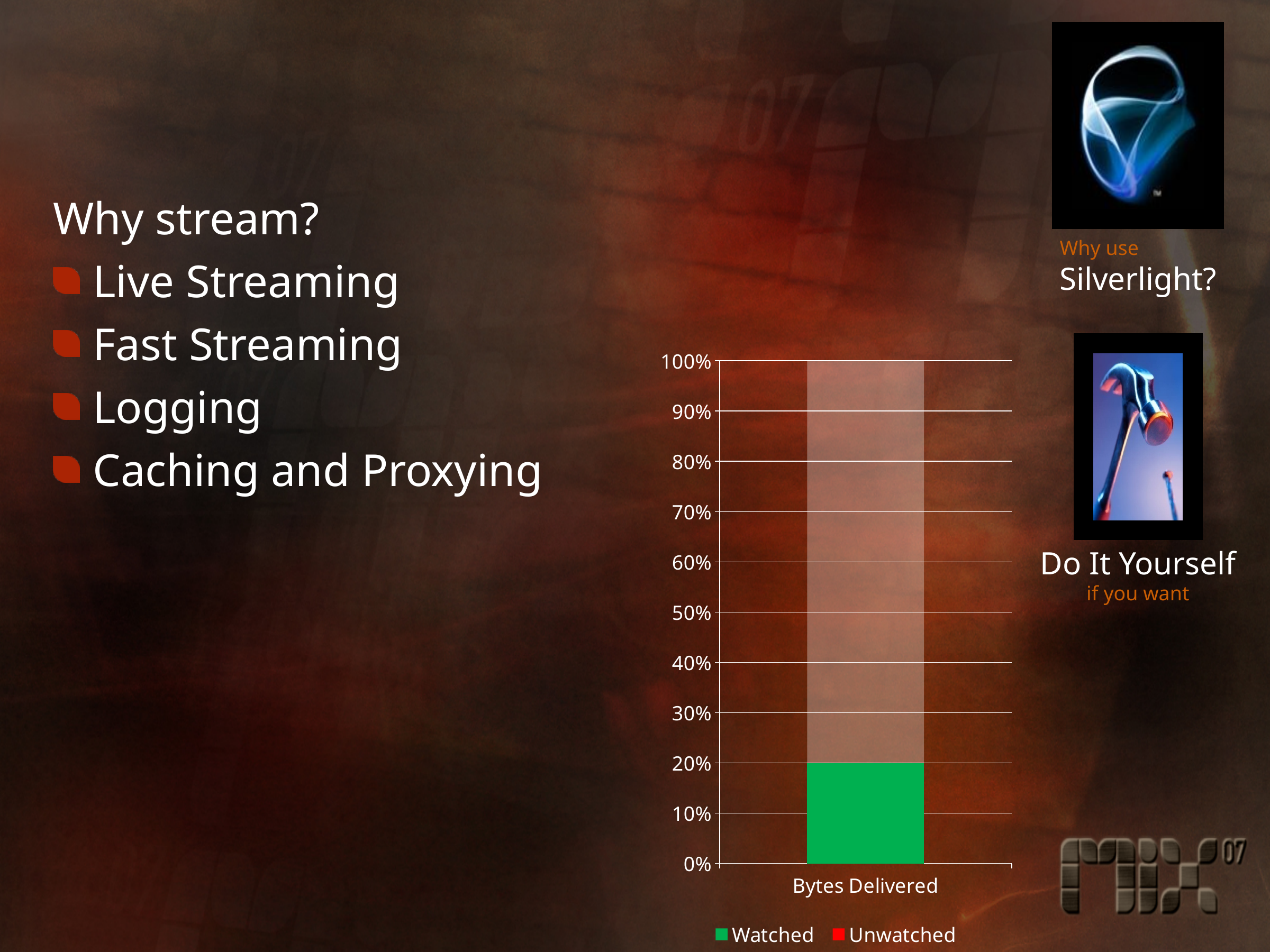
What are the two series named in the chart legend? Watched and Unwatched How many series does the chart legend list? 2 Which series has the smallest segment in the Bytes Delivered bar? Watched What is the Watched value for Bytes Delivered? 20% What is the category label on the x axis of the chart? Bytes Delivered Which series is larger for Bytes Delivered, Watched or Unwatched? Unwatched Is the Watched share of Bytes Delivered greater or less than 30%? less How many categories are shown on the x axis of the chart? 1 What is the total height of the stacked bar for Bytes Delivered? 100% Is the Unwatched share of Bytes Delivered greater or less than 50%? greater What is the highest value shown on the y axis of the chart? 100% What kind of chart is shown on the slide? stacked bar chart